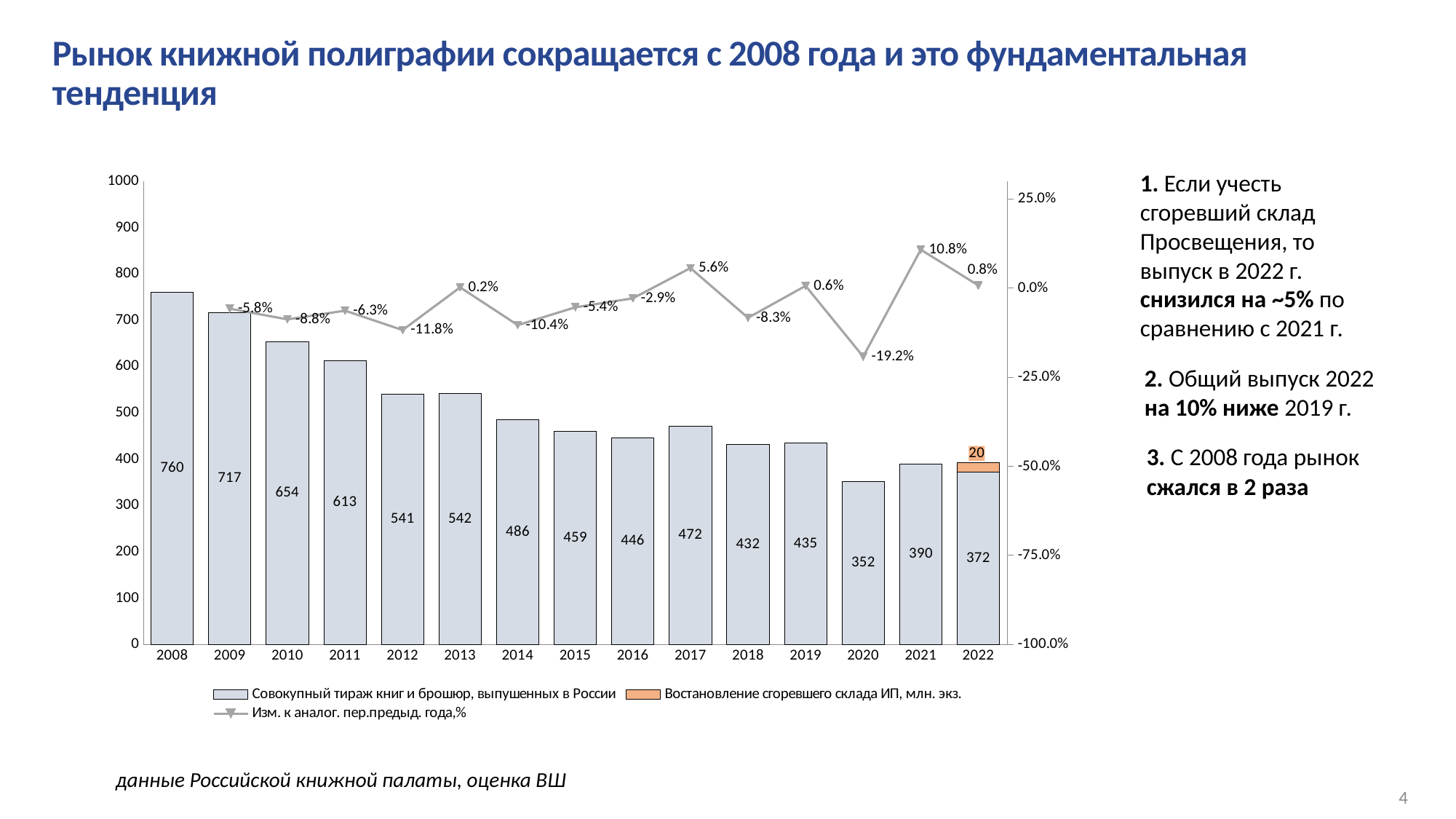
What is the total print run of books and brochures (Совокупный тираж) for 2008? 760 What is the value of the bar for 2020? 352 What is the year-on-year change (Изм. к аналог. пер. предыд. года, %) shown for 2020? -19.2% What kind of chart is this? Combined bar and line chart Which is larger, the bar value for 2017 or for 2018? 2017 What is the value of the orange segment (Востановление сгоревшего склада ИП) in 2022? 20 Which year has the highest bar for total print run? 2008 Which year has the lowest bar for total print run? 2020 What is the total height of the stacked bar for 2022 (372 plus the orange 20)? 392 How many series does the legend list? 3 How many years are shown on the x axis? 15 What is the difference between the bar values for 2008 and 2022 (372)? 388